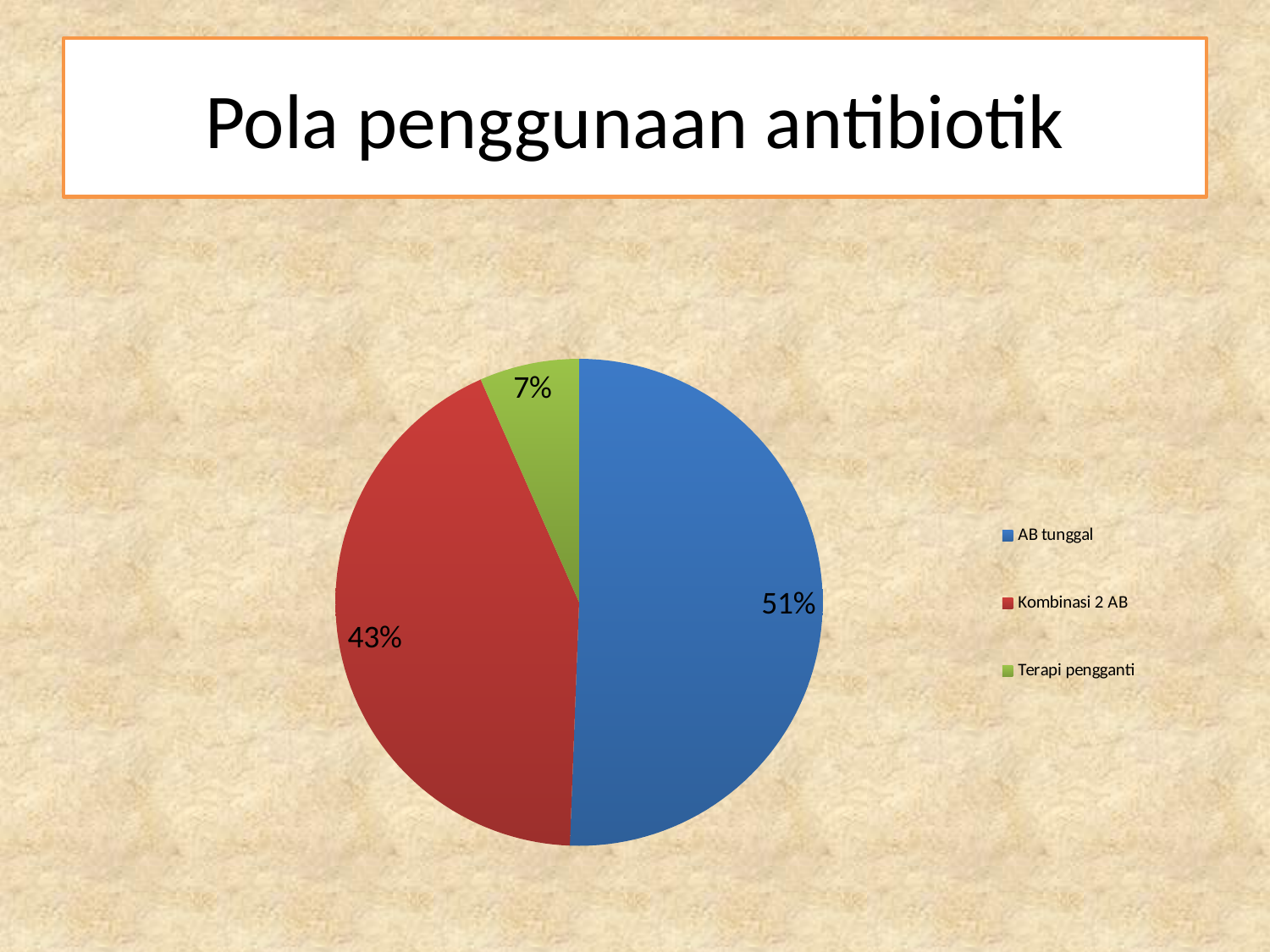
Which is larger, the slice for Kombinasi 2 AB or the slice for Terapi pengganti? Kombinasi 2 AB What share of the pie does Kombinasi 2 AB represent? 43% What share of the pie does Terapi pengganti represent? 7% What share of the pie does AB tunggal represent? 51% How many categories are shown in the pie chart? 3 What is the difference in percentage points between AB tunggal and Kombinasi 2 AB? 8 What colour is the slice for Terapi pengganti? Green What is the difference in percentage points between Kombinasi 2 AB and Terapi pengganti? 36 Which category has the largest slice of the pie? AB tunggal What kind of chart is shown on the slide? Pie chart Which category has the smallest slice of the pie? Terapi pengganti What is the title of the slide containing the chart? Pola penggunaan antibiotik